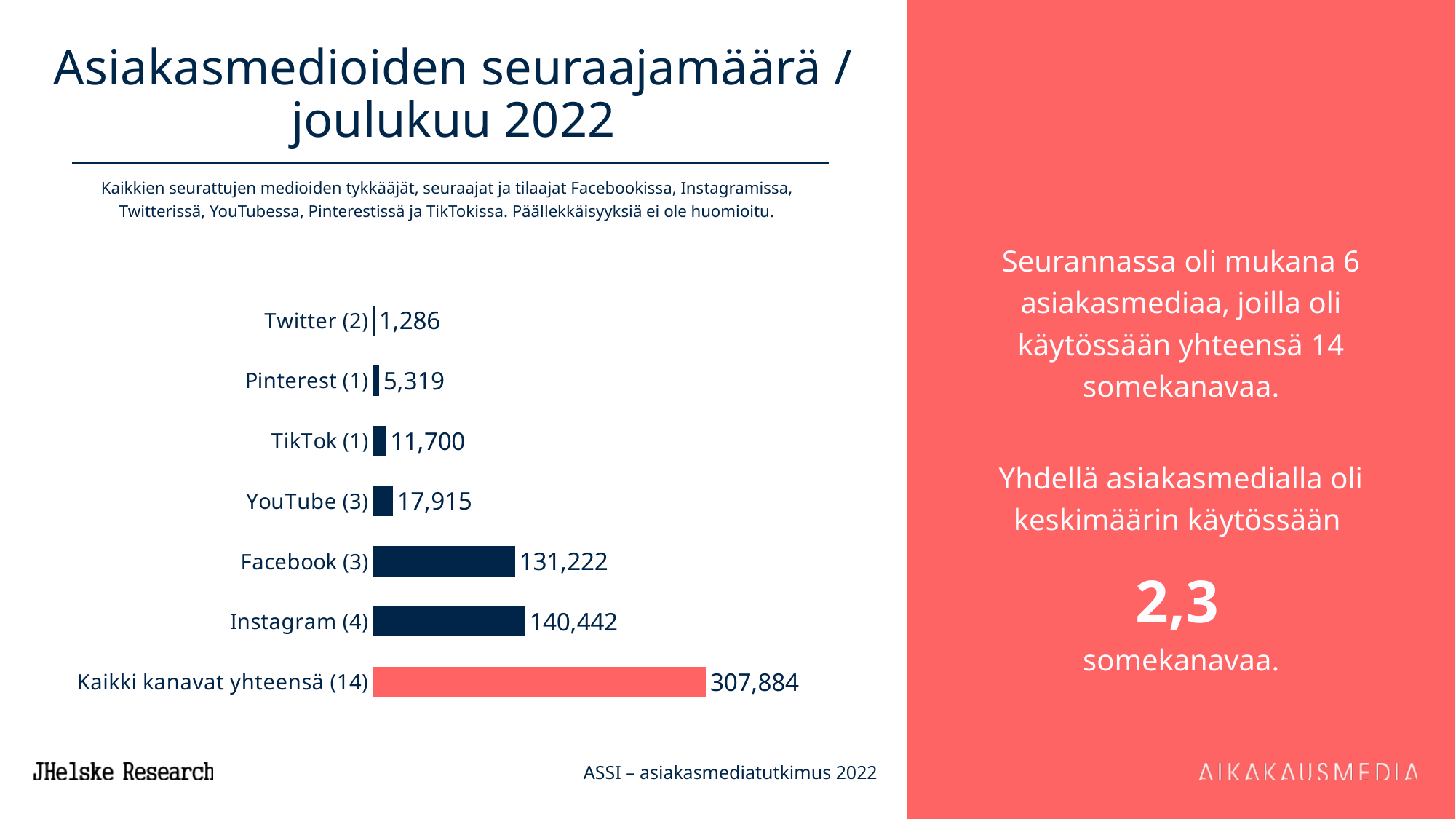
Which category has the lowest value? Twitter (2) What is the value for Twitter (2)? 1,286 What is the difference between the values for Instagram (4) and Facebook (3)? 9,220 Which bar is shown in a different colour from the others? Kaikki kanavat yhteensä (14) What is the value for TikTok (1)? 11,700 What kind of chart is shown on the slide? Bar chart What is the value for Kaikki kanavat yhteensä (14)? 307,884 What is the value for Instagram (4)? 140,442 Which is larger, the value for YouTube (3) or the value for TikTok (1)? YouTube (3) Which category has the highest value? Kaikki kanavat yhteensä (14) How many categories are shown in the chart? 7 What is the value for Facebook (3)? 131,222